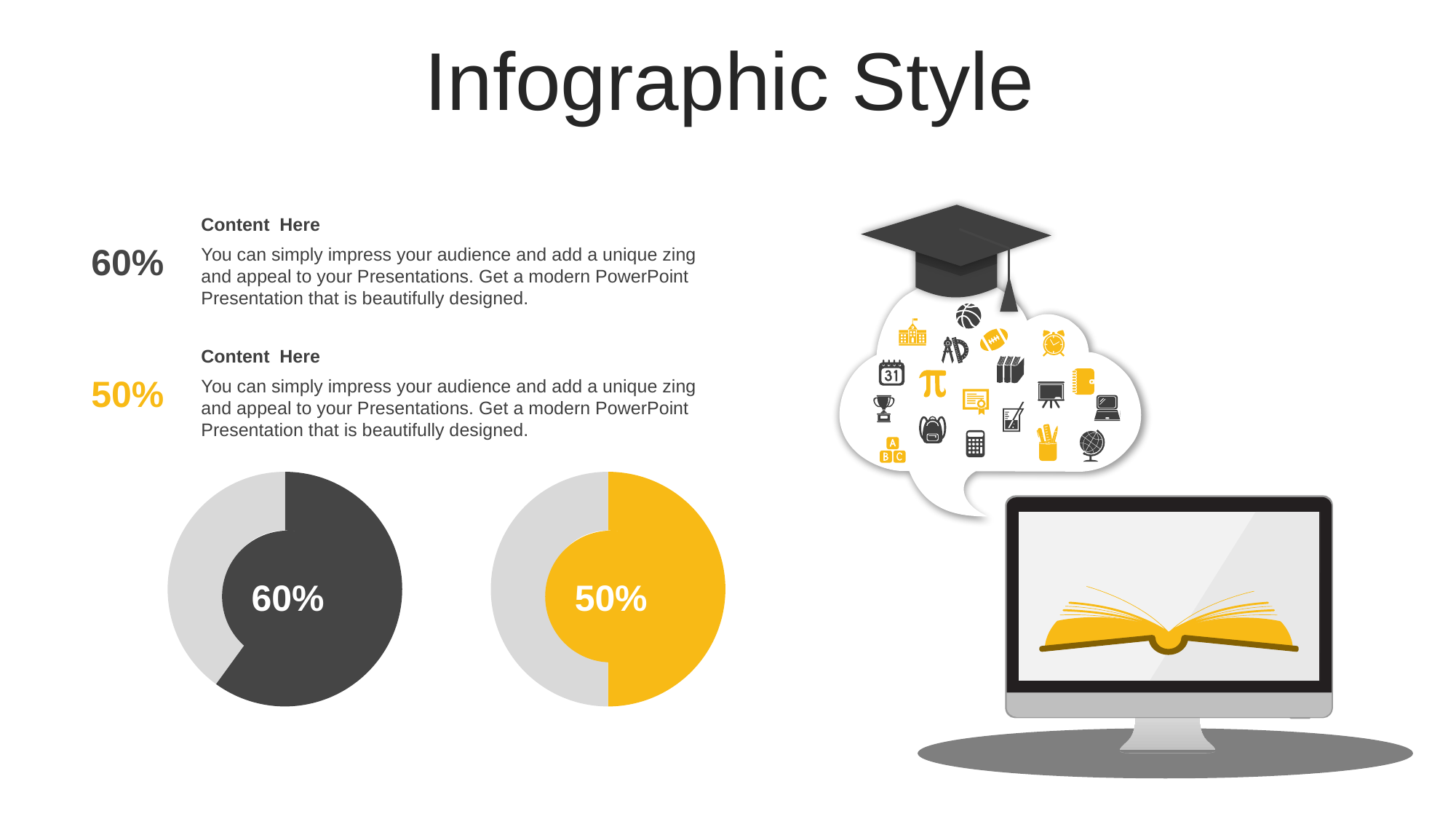
What percentage is shown in the centre of the left pie chart? 60% How many slices does each pie chart have? 2 What percentage is shown in the centre of the right pie chart? 50% What colour is the filled slice of the right pie chart? Yellow What is the difference between the percentage in the left chart and the percentage in the right chart? 10 percentage points In the left pie chart, what share does the light grey (unfilled) slice represent? 40% What kind of chart is used for the two percentage graphics at the bottom left of the slide? Pie chart How many pie charts are shown on the slide? 2 In the right pie chart, what share does the light grey (unfilled) slice represent? 50% Which chart shows the larger percentage, the left (dark grey) chart or the right (yellow) chart? The left (dark grey) chart Is the value shown in the left pie chart greater or less than 50%? greater What colour is the filled slice of the left pie chart? Dark grey